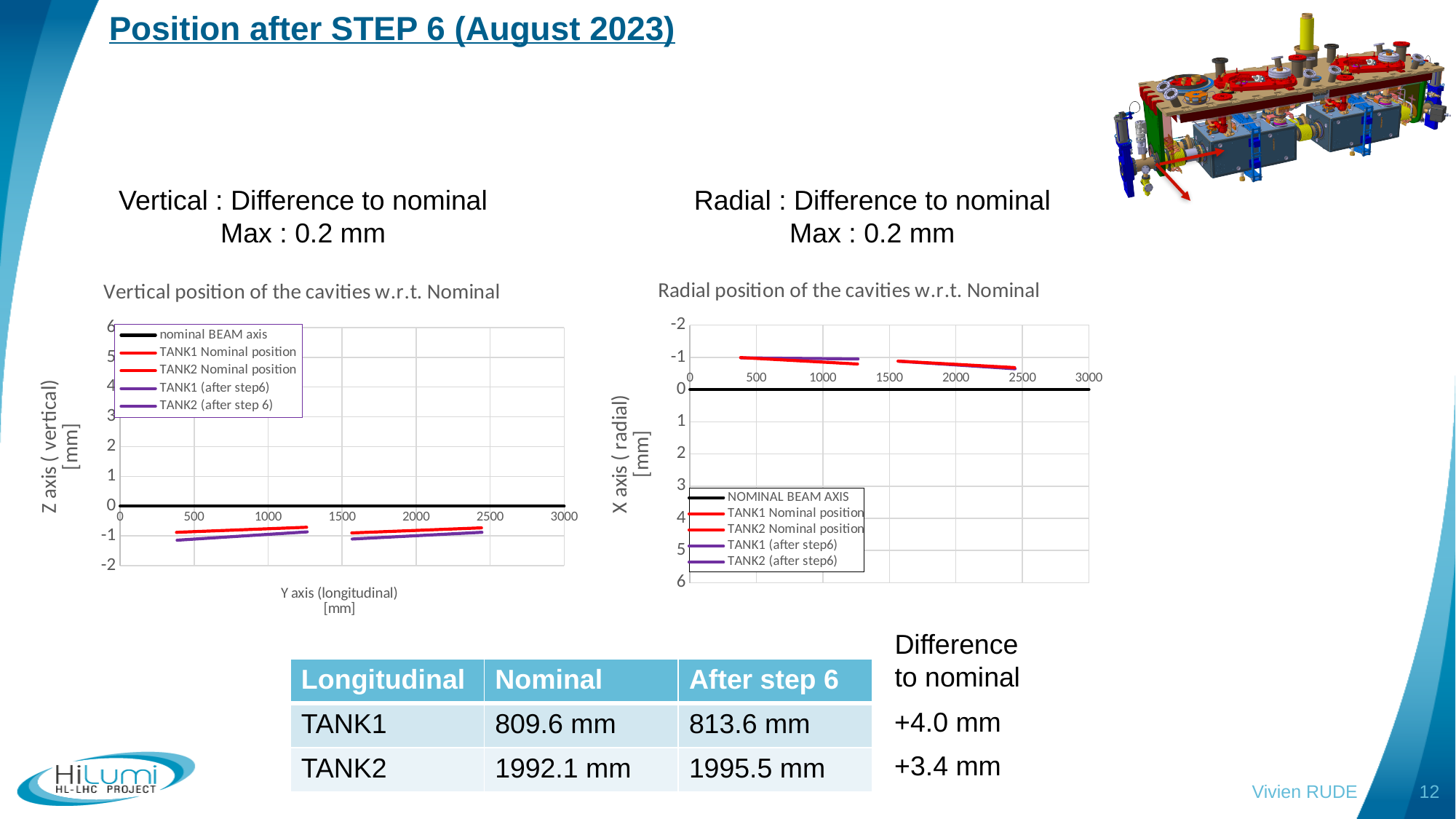
What kind of chart is the 'Radial position of the cavities w.r.t. Nominal' chart? line chart How many series does the legend of the 'Radial position of the cavities w.r.t. Nominal' chart list? 5 What kind of chart is the 'Vertical position of the cavities w.r.t. Nominal' chart? line chart In the 'Vertical position of the cavities w.r.t. Nominal' chart, are the values of the TANK1 Nominal position series greater or less than 0? less In the 'Vertical position of the cavities w.r.t. Nominal' chart, do the values of the TANK1 (after step6) series rise or fall along the x axis? rise In the 'Vertical position of the cavities w.r.t. Nominal' chart, what is the highest value shown on the x axis? 3000 In the 'Radial position of the cavities w.r.t. Nominal' chart, what is the label of the vertical axis? X axis ( radial) [mm] In the 'Radial position of the cavities w.r.t. Nominal' chart, are the values of the TANK1 Nominal position series greater or less than 0? less In the 'Vertical position of the cavities w.r.t. Nominal' chart, what is the label of the vertical axis? Z axis ( vertical) [mm] In the 'Vertical position of the cavities w.r.t. Nominal' chart, are the values of the TANK2 (after step 6) series greater or less than -2? greater How many series does the legend of the 'Vertical position of the cavities w.r.t. Nominal' chart list? 5